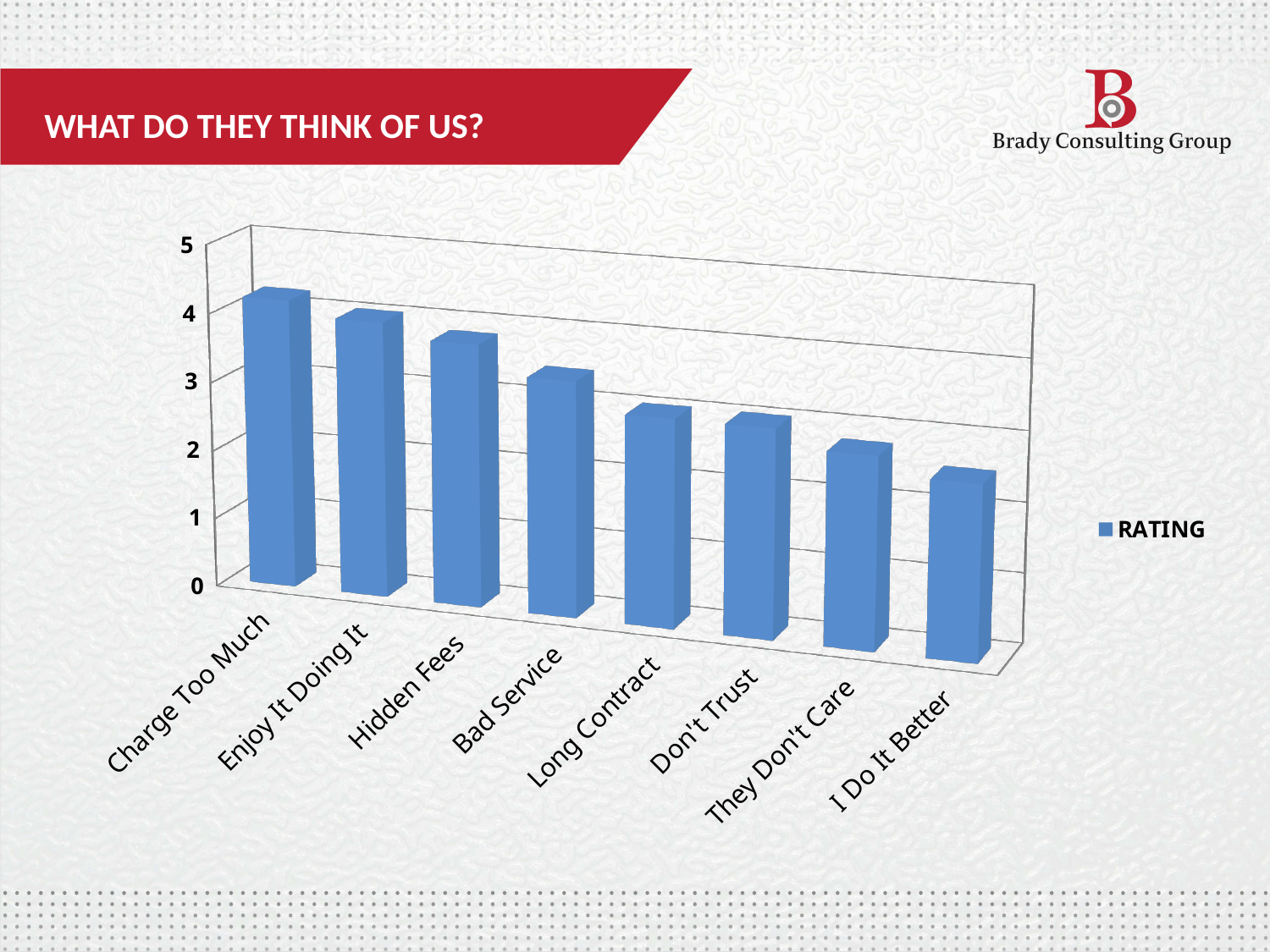
What kind of chart is shown on the slide? bar chart Which category has the lowest rating? I Do It Better How many categories are shown on the x axis of the chart? 8 Do the ratings rise or fall moving from left to right along the x axis? fall How many series does the chart's legend list? 1 Which has a higher rating, Enjoy It Doing It or They Don't Care? Enjoy It Doing It What is the name of the series shown in the chart's legend? RATING Is the rating for Charge Too Much greater or less than 3? greater Is the rating for I Do It Better greater or less than 2? greater Which category has the highest rating? Charge Too Much Which has a higher rating, Hidden Fees or Long Contract? Hidden Fees